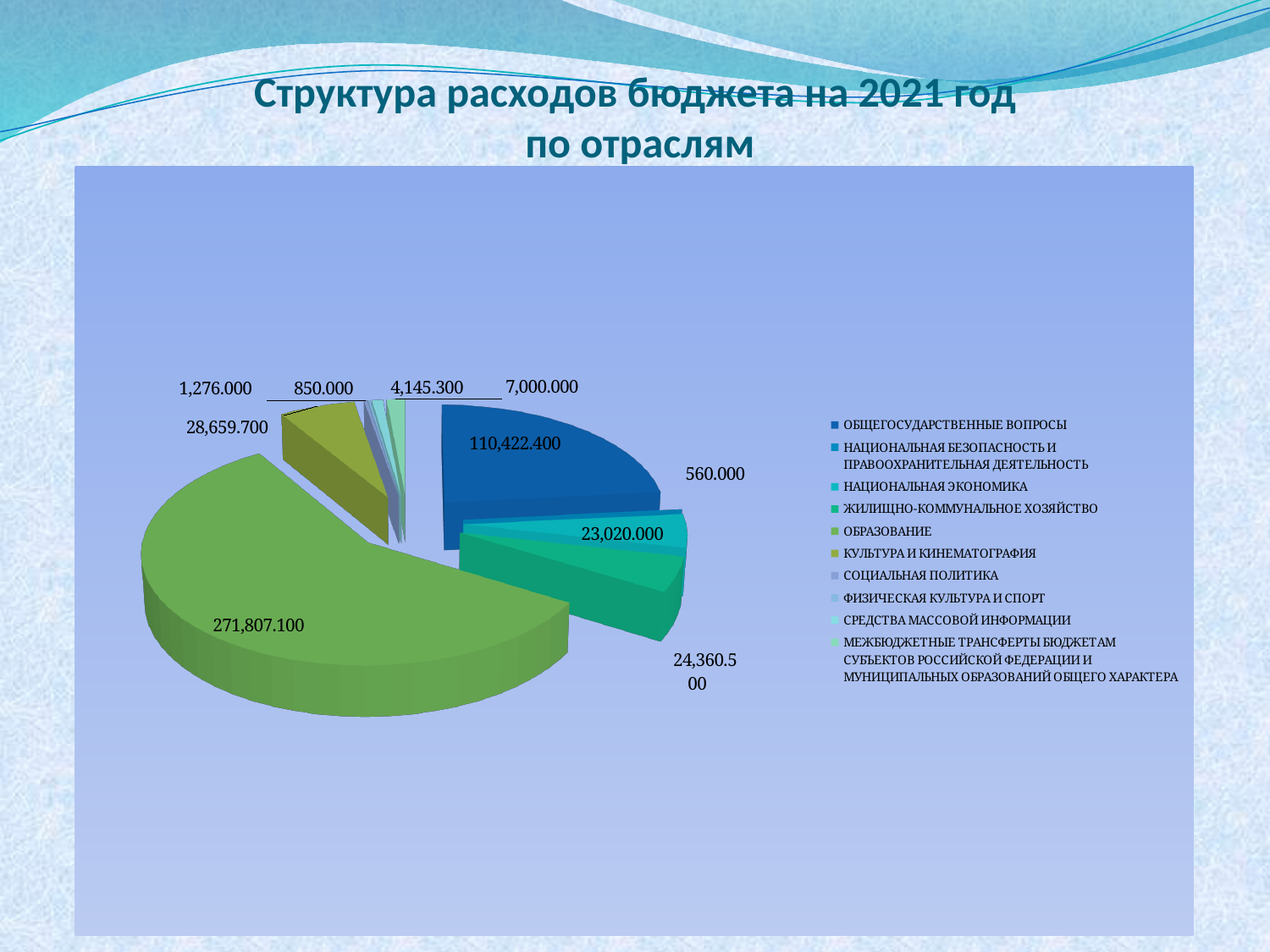
What is the title of the slide containing the pie chart? Структура расходов бюджета на 2021 год по отраслям Which is larger: the value for ЖИЛИЩНО-КОММУНАЛЬНОЕ ХОЗЯЙСТВО or the value for НАЦИОНАЛЬНАЯ ЭКОНОМИКА? ЖИЛИЩНО-КОММУНАЛЬНОЕ ХОЗЯЙСТВО How many categories does the legend of the pie chart list? 10 What is the value for НАЦИОНАЛЬНАЯ ЭКОНОМИКА in the pie chart? 23,020.000 What is the value for ОБЩЕГОСУДАРСТВЕННЫЕ ВОПРОСЫ in the pie chart? 110,422.400 What is the value for ЖИЛИЩНО-КОММУНАЛЬНОЕ ХОЗЯЙСТВО in the pie chart? 24,360.500 What is the value for КУЛЬТУРА И КИНЕМАТОГРАФИЯ in the pie chart? 28,659.700 Which category has the smallest value in the pie chart? НАЦИОНАЛЬНАЯ БЕЗОПАСНОСТЬ И ПРАВООХРАНИТЕЛЬНАЯ ДЕЯТЕЛЬНОСТЬ What is the value for ОБРАЗОВАНИЕ in the pie chart? 271,807.100 What is the difference between the values for ОБРАЗОВАНИЕ and ОБЩЕГОСУДАРСТВЕННЫЕ ВОПРОСЫ? 161,384.700 Which category has the largest slice in the pie chart? ОБРАЗОВАНИЕ What type of chart is shown on the slide? pie chart